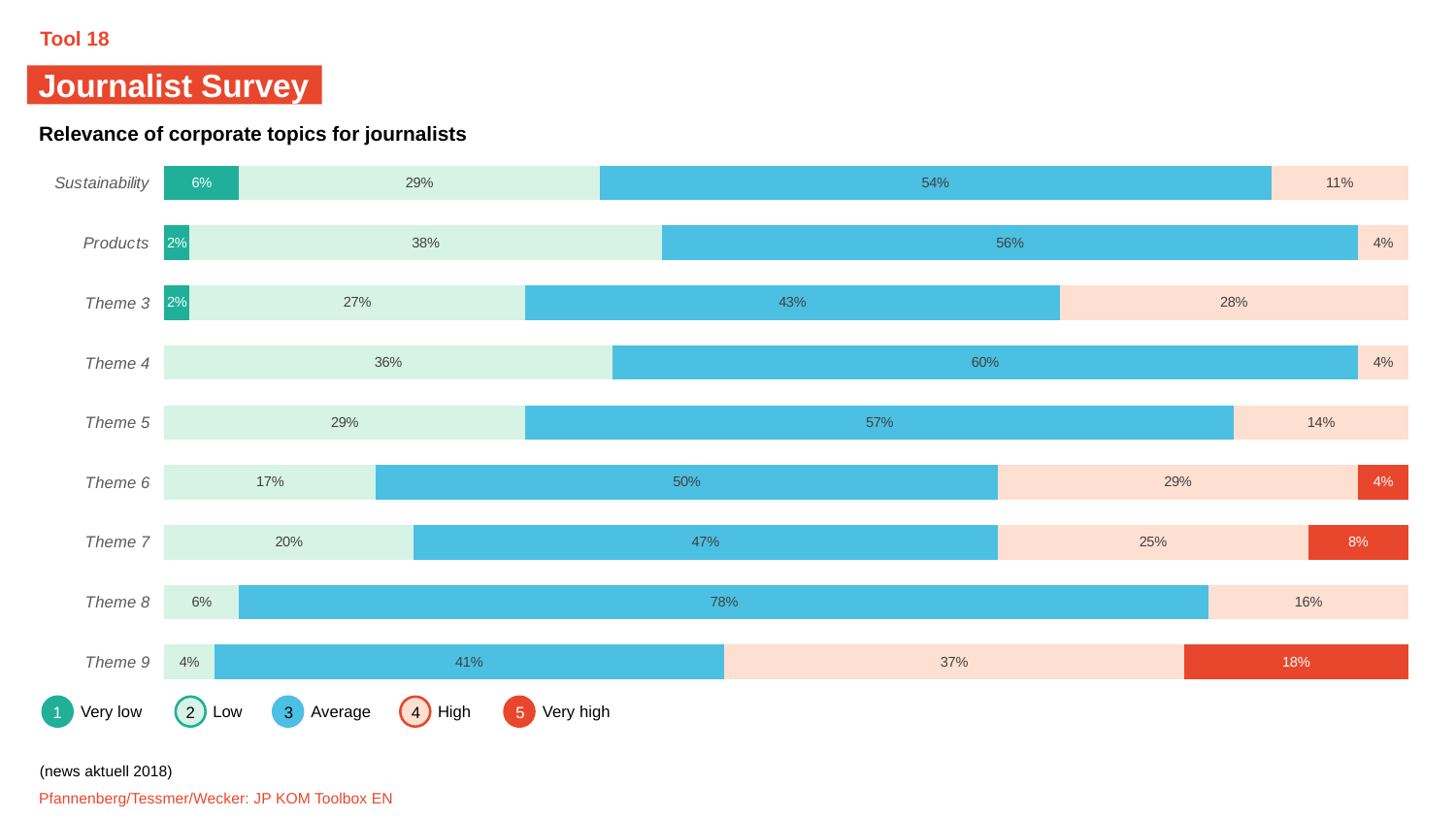
What is the total of the Sustainability bar (6%, 29%, 54% and 11%)? 100% Which is larger: the Low share for Products or the Low share for Theme 3? Products What is the difference between the High share for Theme 9 and the High share for Theme 7? 12% What percentage of journalists rated Sustainability as Average? 54% What is the Very high share for Theme 9? 18% How many rating categories does the legend list? 5 Which topic has the highest Very high share? Theme 9 What type of chart is shown on the slide? Stacked bar chart What is the Low share for Theme 4? 36% Which topic has the highest Average share? Theme 8 Which topic has the lowest Average share? Theme 9 How many topics are shown in the chart? 9